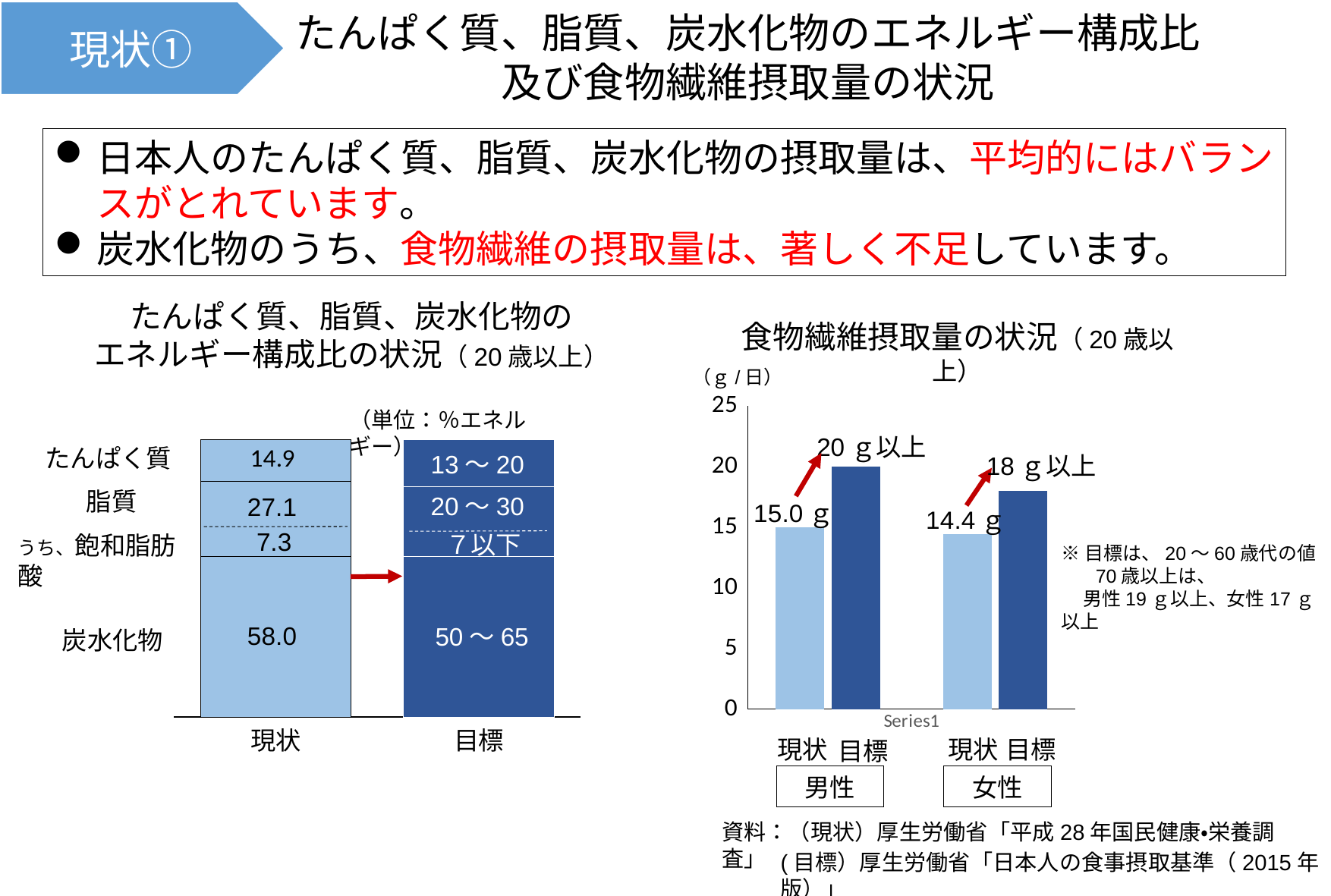
What kind of chart is the right chart (食物繊維摂取量の状況)? bar chart In the right chart (食物繊維摂取量の状況), which has the higher 現状 value, 男性 or 女性? 男性 In the left chart (たんぱく質、脂質、炭水化物のエネルギー構成比の状況), what is the 現状 value for たんぱく質? 14.9 In the right chart (食物繊維摂取量の状況), what is the 目標 value for 女性? 18 g以上 In the left chart (たんぱく質、脂質、炭水化物のエネルギー構成比の状況), what is the 目標 range for 脂質? 20〜30 In the right chart (食物繊維摂取量の状況), what is the difference between the 現状 values for 男性 and 女性? 0.6 g In the right chart (食物繊維摂取量の状況), what is the 現状 value for 女性? 14.4 g In the left chart (たんぱく質、脂質、炭水化物のエネルギー構成比の状況), what is the 現状 value for 炭水化物? 58.0 In the right chart (食物繊維摂取量の状況), is the 目標 bar for 男性 greater or less than 15? greater In the right chart (食物繊維摂取量の状況), what is the 現状 value for 男性? 15.0 g In the left chart (たんぱく質、脂質、炭水化物のエネルギー構成比の状況), what is the difference between the 現状 values for 炭水化物 and 脂質? 30.9 In the left chart (たんぱく質、脂質、炭水化物のエネルギー構成比の状況), which component has the largest 現状 value? 炭水化物